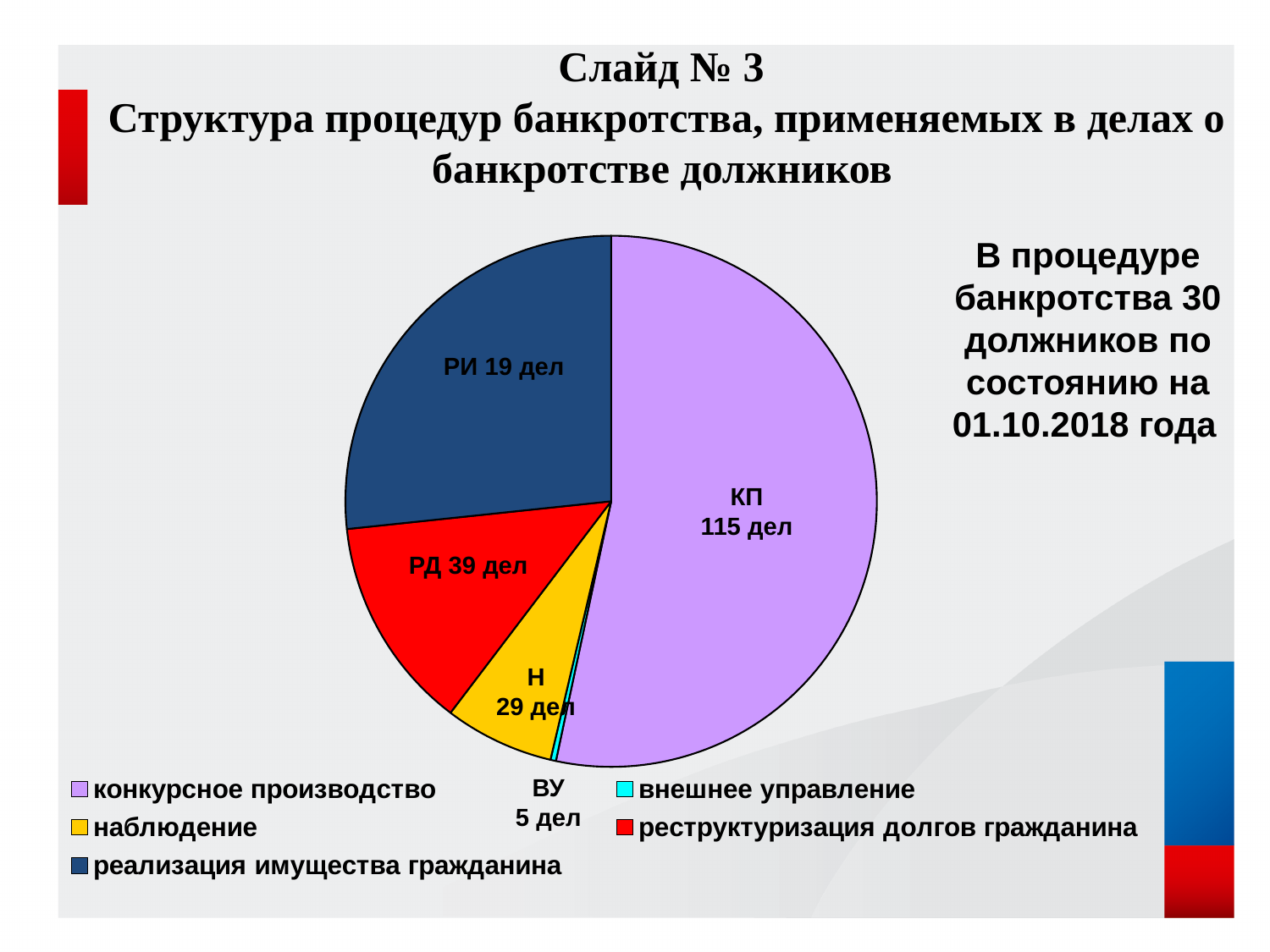
How many cases are shown for the ВУ slice? 5 дел How many slices does the pie chart have? 5 How many cases are shown for the РД slice? 39 дел How many cases are shown for the РИ slice? 19 дел What type of chart is shown on the slide? pie chart Which slice of the pie chart has the largest number of cases? КП How many cases (дел) are shown for the КП slice? 115 дел How many entries does the legend list? 5 Which slice of the pie chart has the smallest number of cases? ВУ What is the difference in cases between the КП slice and the РД slice? 76 What colour is the slice for конкурсное производство? light purple